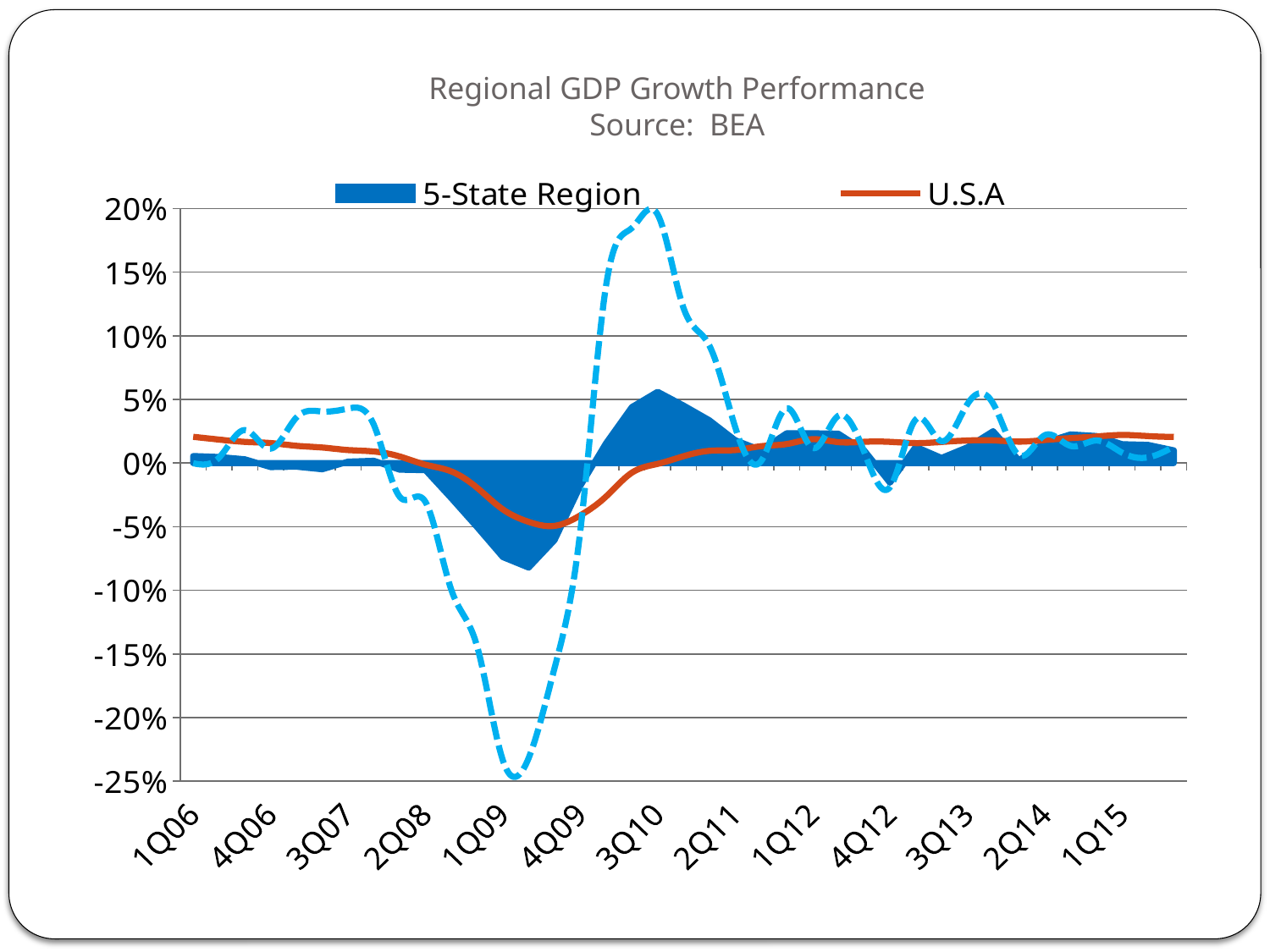
Does the U.S.A series rise or fall between 4Q09 and 2Q11? rise Is the 5-State Region value at 1Q09 greater or less than -5%? less How many series does the legend list? 2 Is the 5-State Region value at 3Q10 greater or less than 0%? greater At 3Q10, which series has the higher value, 5-State Region or U.S.A? 5-State Region What source is cited under the chart title? BEA How many quarter labels are shown on the x axis? 13 Is the U.S.A value at 1Q06 greater or less than 0%? greater At 1Q09, which series has the lower value, 5-State Region or U.S.A? 5-State Region What is the title of the chart? Regional GDP Growth Performance Does the 5-State Region series rise or fall between 2Q08 and 1Q09? fall